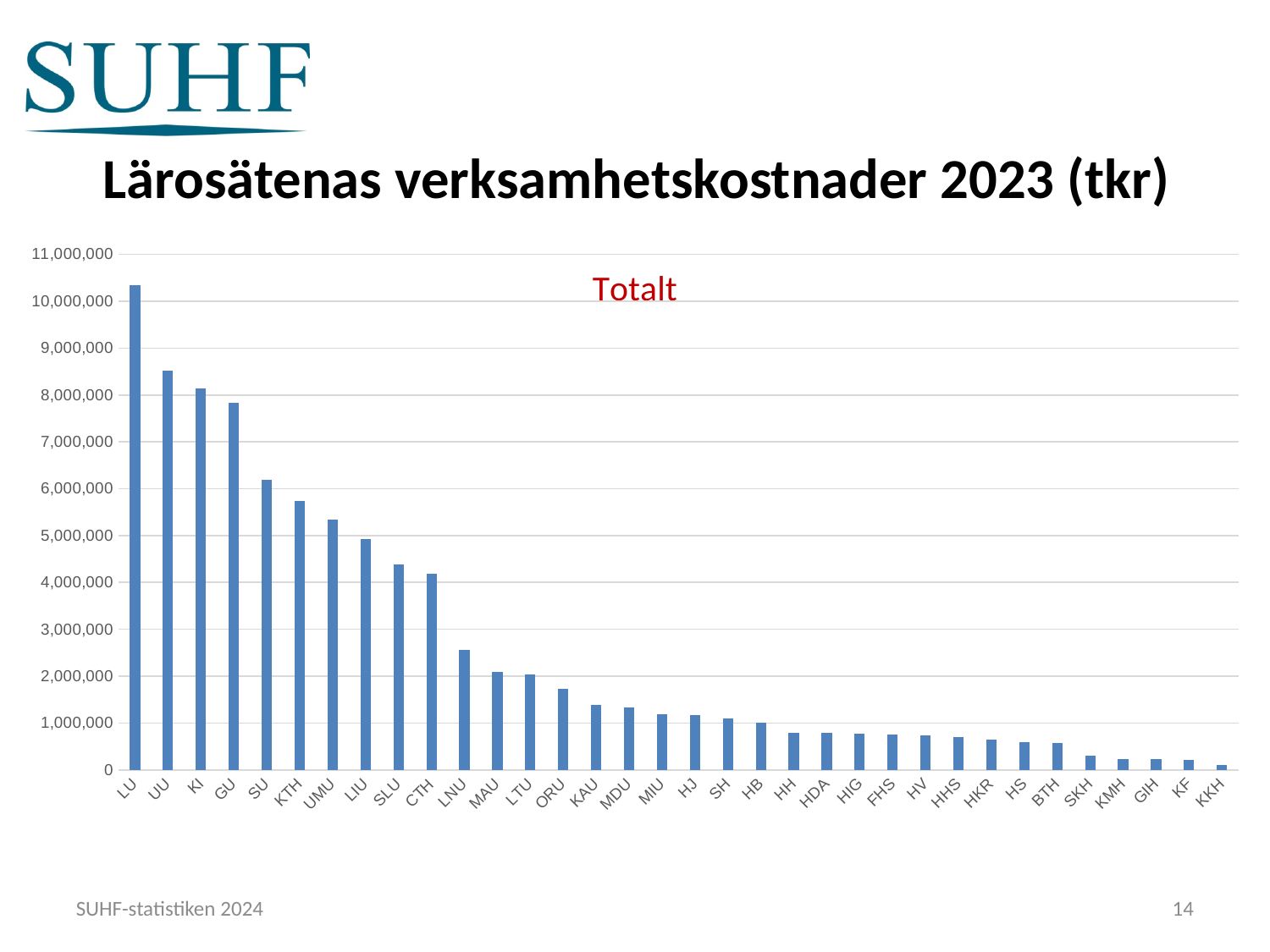
Which institution has the lowest verksamhetskostnader in the chart? KKH What label is shown in red above the bars in the chart? Totalt What is the title of the chart? Lärosätenas verksamhetskostnader 2023 (tkr) Do the bar values rise or fall from left to right along the x axis? fall Which institution has the highest verksamhetskostnader in the chart? LU Which has the larger value, UU or KI? UU Is the value for SU greater or less than 6,000,000? greater Is the value for UU greater or less than 8,000,000? greater Is the value for LU greater or less than 10,000,000? greater What kind of chart is shown on the slide? bar chart How many institutions are shown on the x axis of the chart? 34